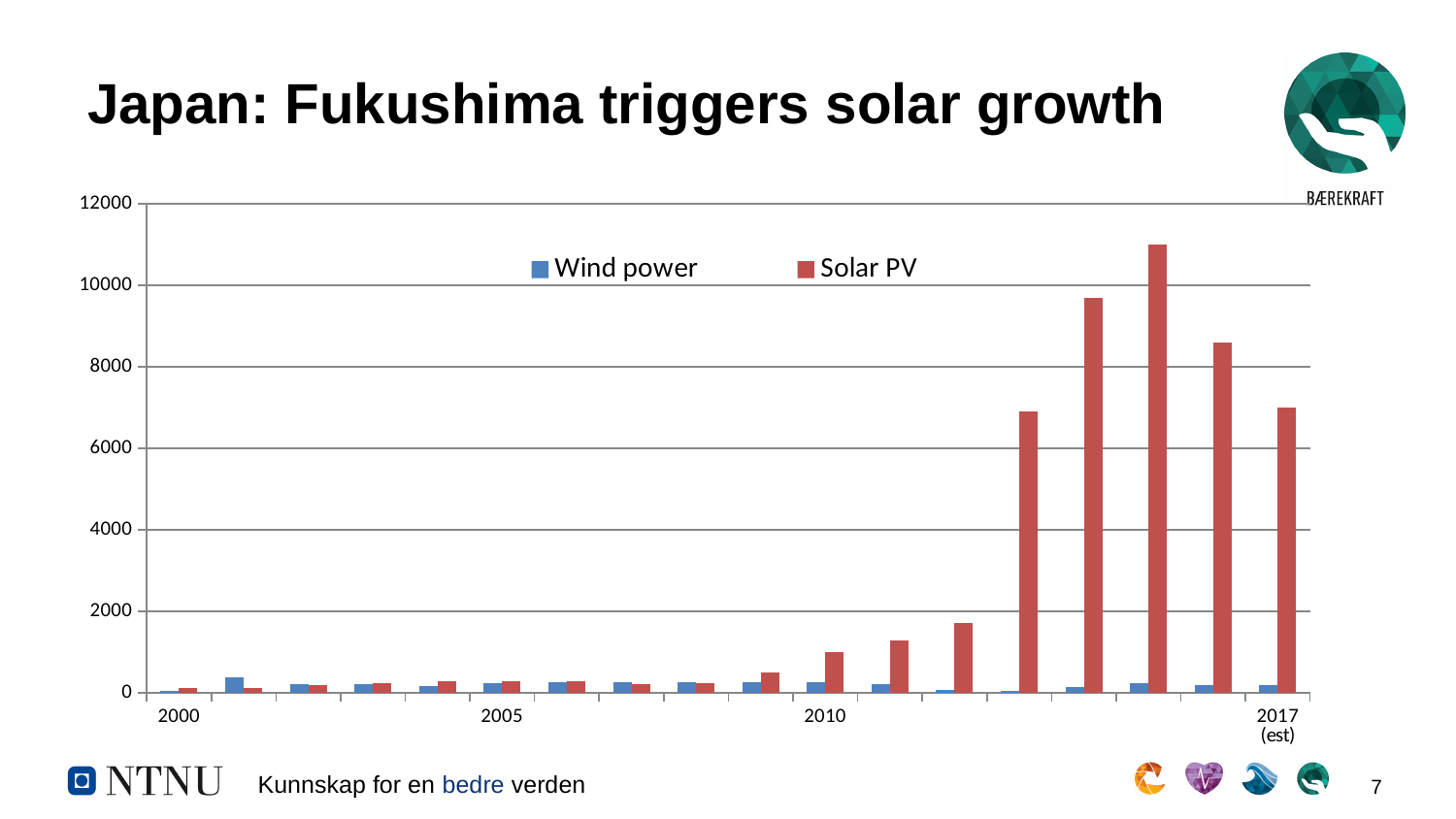
Is the Solar PV value for 2005 greater or less than 2000? less Which series has the tallest bar in the chart? Solar PV What kind of chart is shown on the slide? Bar chart In 2017 (est), which series has the larger value, Wind power or Solar PV? Solar PV What are the two series named in the legend? Wind power and Solar PV How many years (categories) are plotted on the x axis, from 2000 to 2017 (est)? 18 What is the title of the slide containing the chart? Japan: Fukushima triggers solar growth Do the Solar PV values generally rise or fall from 2000 to 2010? rise Is the Solar PV value for 2010 greater or less than 2000? less Is the Wind power value for 2017 (est) greater or less than 2000? less How many series does the legend list? 2